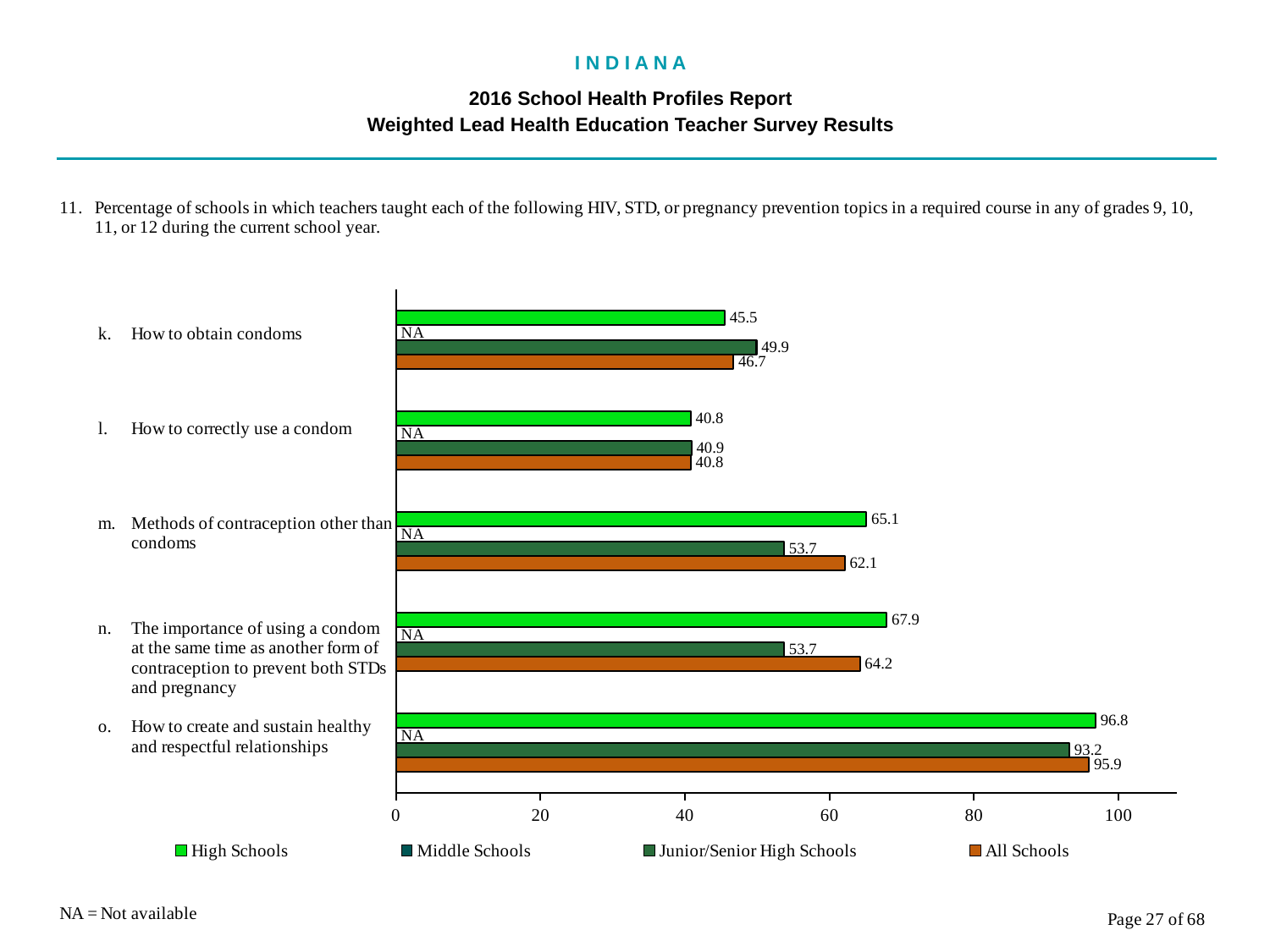
What is the difference between the High Schools and Junior/Senior High Schools values for 'The importance of using a condom at the same time as another form of contraception to prevent both STDs and pregnancy'? 14.2 Is the All Schools value for 'Methods of contraception other than condoms' greater or less than 60? greater What is the All Schools value for 'How to create and sustain healthy and respectful relationships'? 95.9 Which topic has the highest High Schools value? How to create and sustain healthy and respectful relationships Which topic has the lowest All Schools value? How to correctly use a condom How many topics are listed on the chart? 5 What is the All Schools value for 'How to correctly use a condom'? 40.8 What value is shown for Middle Schools across all topics? NA What is the High Schools value for 'How to obtain condoms'? 45.5 What is the Junior/Senior High Schools value for 'Methods of contraception other than condoms'? 53.7 For 'How to obtain condoms', which is larger: the High Schools value or the Junior/Senior High Schools value? Junior/Senior High Schools How many series does the legend list? 4